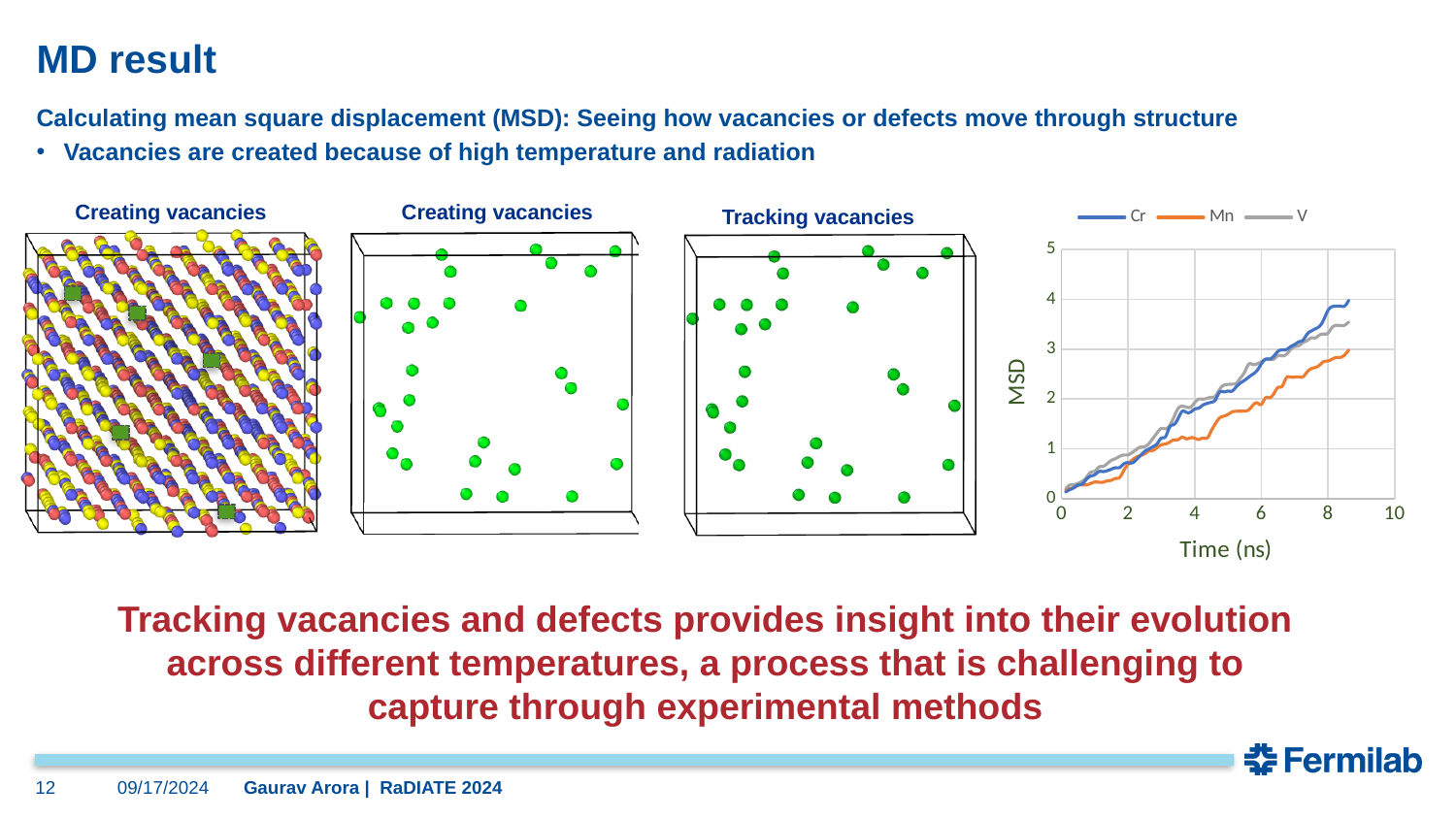
What is the x-axis title of the MSD chart? Time (ns) In the MSD chart, which series has the lowest MSD at the end of the plotted time range? Mn In the MSD chart, is the MSD value for Cr at 8 ns greater or less than 3? greater In the MSD chart, is the MSD value for Mn at 4 ns greater or less than 2? less Which series are listed in the legend of the MSD chart? Cr, Mn, V In the MSD chart, do the MSD values rise or fall as time increases? rise In the MSD chart, at the end of the plotted time range, which series has the larger MSD, Cr or Mn? Cr In the MSD chart, is the MSD value for Cr at 2 ns greater or less than 1? less What kind of chart is the MSD chart on the right of the slide? line chart How many series does the legend of the MSD chart list? 3 In the MSD chart, which series reaches the highest MSD value? Cr